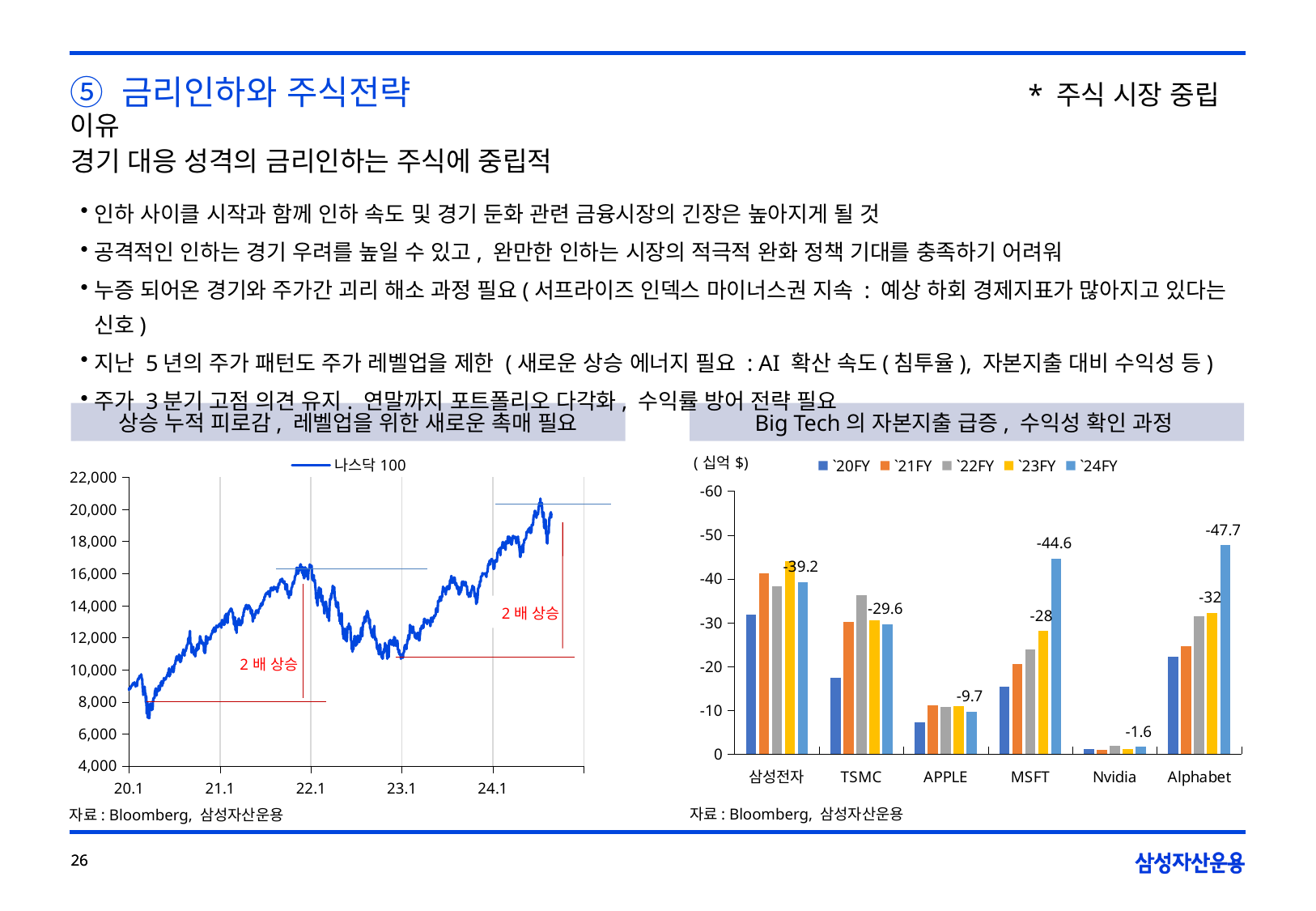
In the right chart, what is the '24FY data label for Alphabet? -47.7 In the right chart, what is the '24FY data label for Nvidia? -1.6 What is the legend entry of the left chart? 나스닥 100 In the right chart, which company has the '24FY data label with the smallest absolute value? Nvidia What kind of chart is the right chart on the slide? bar chart How many series does the legend of the right chart list? 5 In the right chart titled 'Big Tech 의 자본지출 급증 , 수익성 확인 과정', what is the '24FY data label for MSFT? -44.6 In the right chart, by how much does the absolute value of Alphabet's '24FY label (-47.7) exceed MSFT's '24FY label (-44.6)? 3.1 In the right chart, which company has the '24FY data label with the largest absolute value? Alphabet In the right chart, what is the '24FY data label for 삼성전자? -39.2 In the left chart, does the 나스닥 100 line rise or fall between 23.1 and 24.1? rise How many companies are shown on the x axis of the right chart? 6